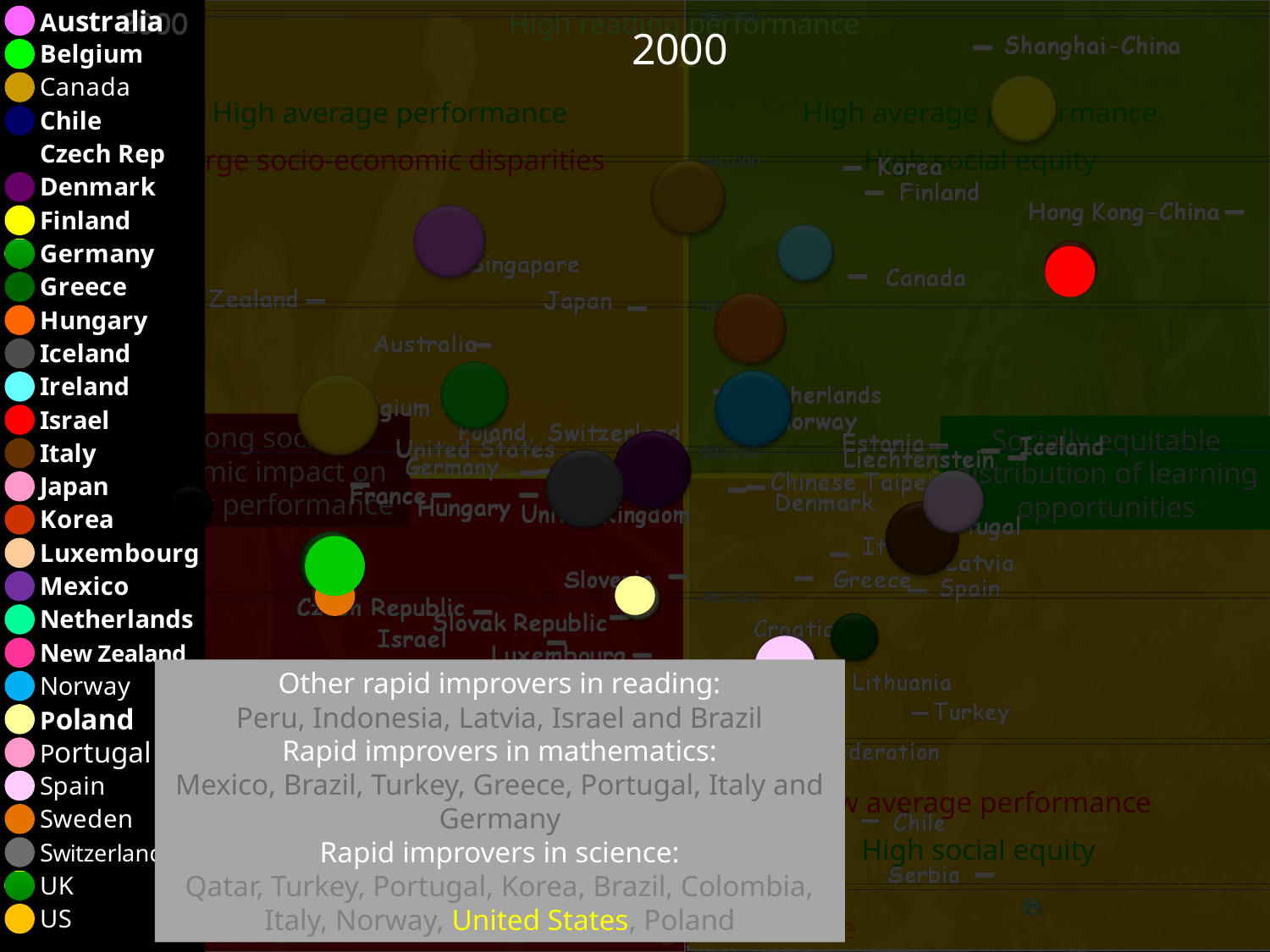
Which bubble is positioned higher on the chart, the red Israel bubble or the bright green Belgium bubble? Israel How many countries does the legend on the left list? 28 Which bubble is positioned higher on the chart, the yellow Finland bubble or the pale yellow Poland bubble? Finland What year is displayed at the top of the chart? 2000 Which country is represented by the red bubble in the legend? Israel Which bubble is further to the right on the chart, the red Israel bubble or the purple Mexico bubble? Israel What kind of chart is shown on the slide? bubble chart